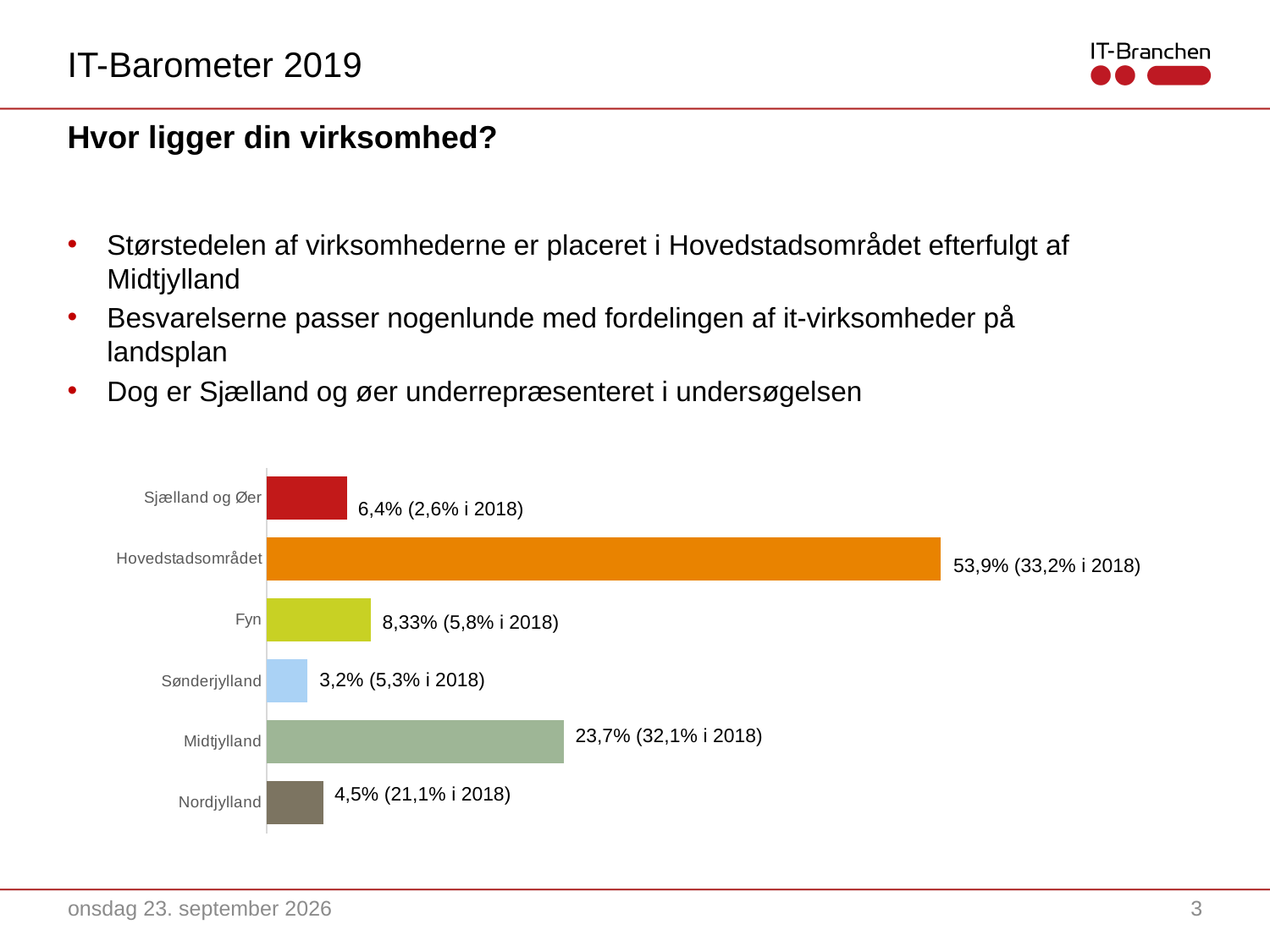
Which is larger, the value for Sjælland og Øer or the value for Nordjylland? Sjælland og Øer What kind of chart is shown on the slide? Bar chart What colour is the bar for Hovedstadsområdet? Orange What is the difference between the values for Hovedstadsområdet and Midtjylland? 30,2% What is the value for Fyn? 8,33% How many regions are shown in the chart? 6 Which region has the lowest value? Sønderjylland Which region has the highest value? Hovedstadsområdet What was the 2018 value shown for Nordjylland? 21,1% What is the difference between the 2019 and 2018 values for Sjælland og Øer? 3,8% What is the value for Midtjylland? 23,7% What is the value for Hovedstadsområdet? 53,9%